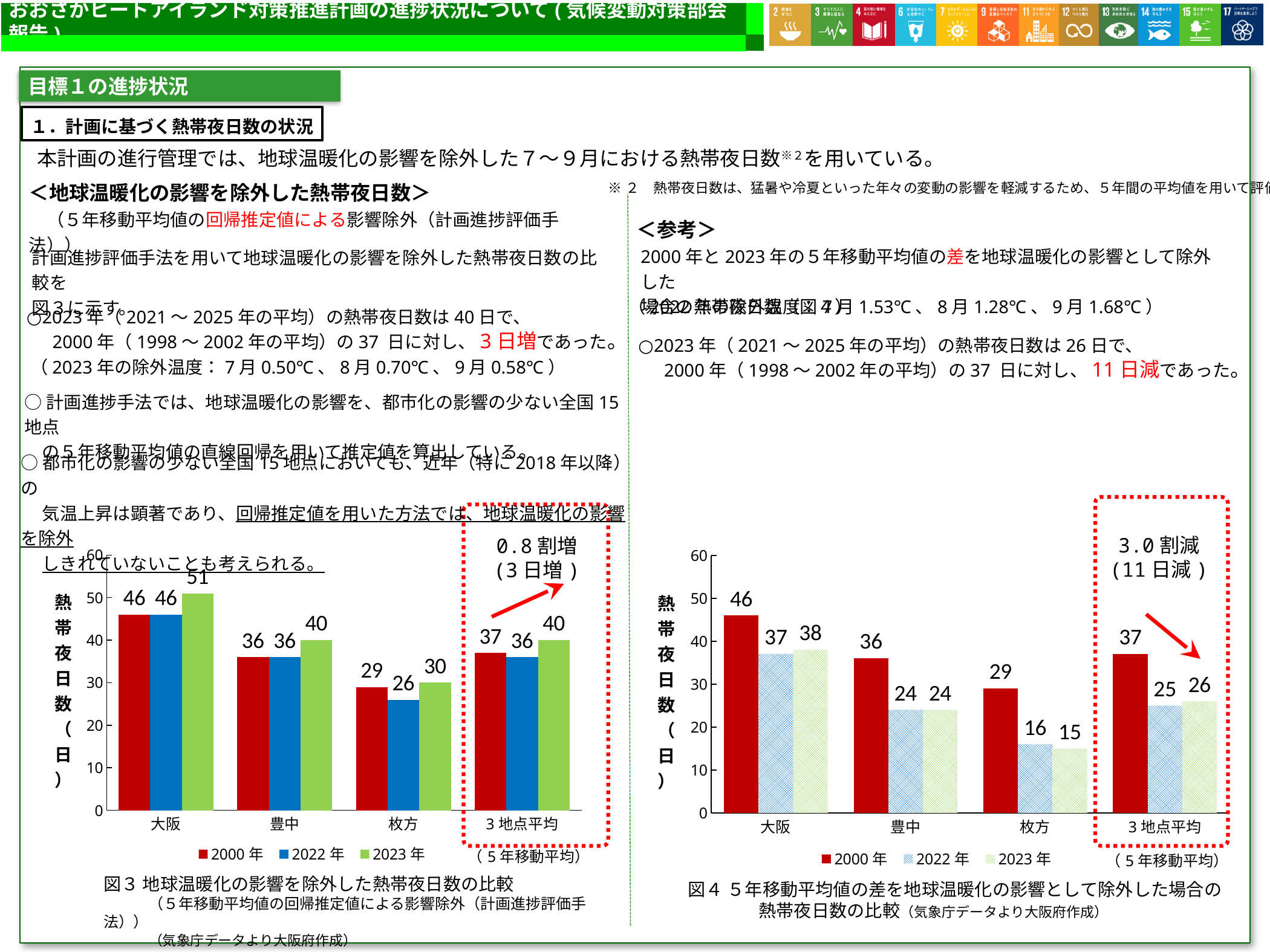
In the right chart (図4), what is the value for 3地点平均 in the 2023年 series? 26 In the left chart (図3), what is the difference between the 2023年 and 2000年 values for 3地点平均? 3 In the left chart (図3), what is the value for 大阪 in the 2023年 series? 51 How many categories are shown on the x axis of the left chart (図3)? 4 What kind of chart is the left chart (図3)? bar chart In the right chart (図4), which category has the lowest value in the 2023年 series? 枚方 In the right chart (図4), which is larger for 枚方: the 2022年 value or the 2023年 value? 2022年 In the left chart (図3), which category has the highest value in the 2000年 series? 大阪 How many series does the legend of the right chart (図4) list? 3 In the right chart (図4), what is the value for 豊中 in the 2022年 series? 24 In the right chart (図4), what is the difference between the 2000年 and 2023年 values for 3地点平均? 11 In the left chart (図3), what is the value for 枚方 in the 2022年 series? 26